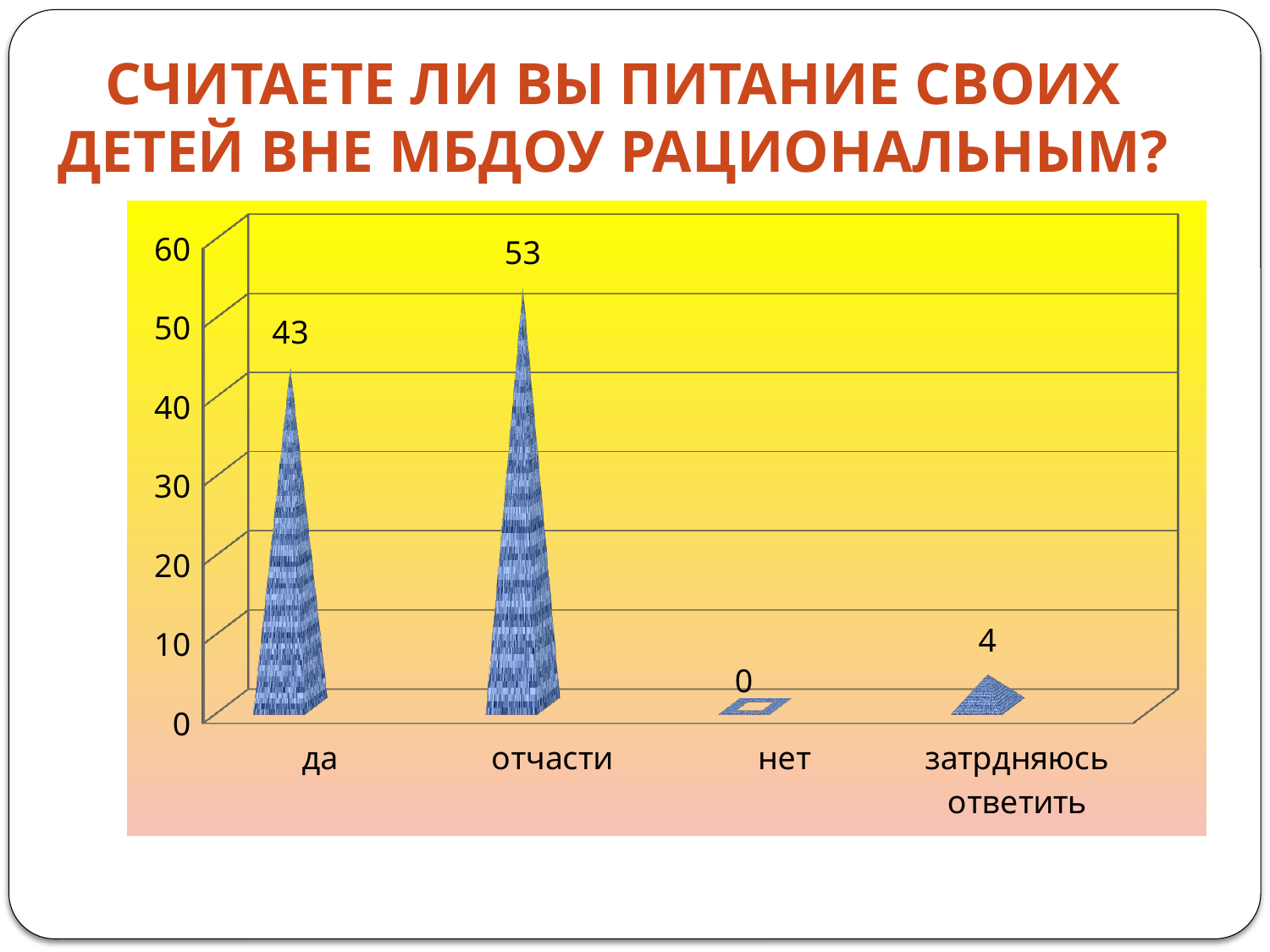
What is the value for "да"? 43 What is the title of the slide? СЧИТАЕТЕ ЛИ ВЫ ПИТАНИЕ СВОИХ ДЕТЕЙ ВНЕ МБДОУ РАЦИОНАЛЬНЫМ? Which category has the highest value? отчасти What kind of chart is shown on the slide? bar chart How many categories are shown on the x axis? 4 What is the value for "отчасти"? 53 What is the value for "нет"? 0 Which category has the lowest value? нет What is the difference between the values for "отчасти" and "да"? 10 Which is larger, the value for "да" or the value for "затрдняюсь ответить"? да Is the value for "отчасти" greater or less than 50? greater What is the value for "затрдняюсь ответить"? 4